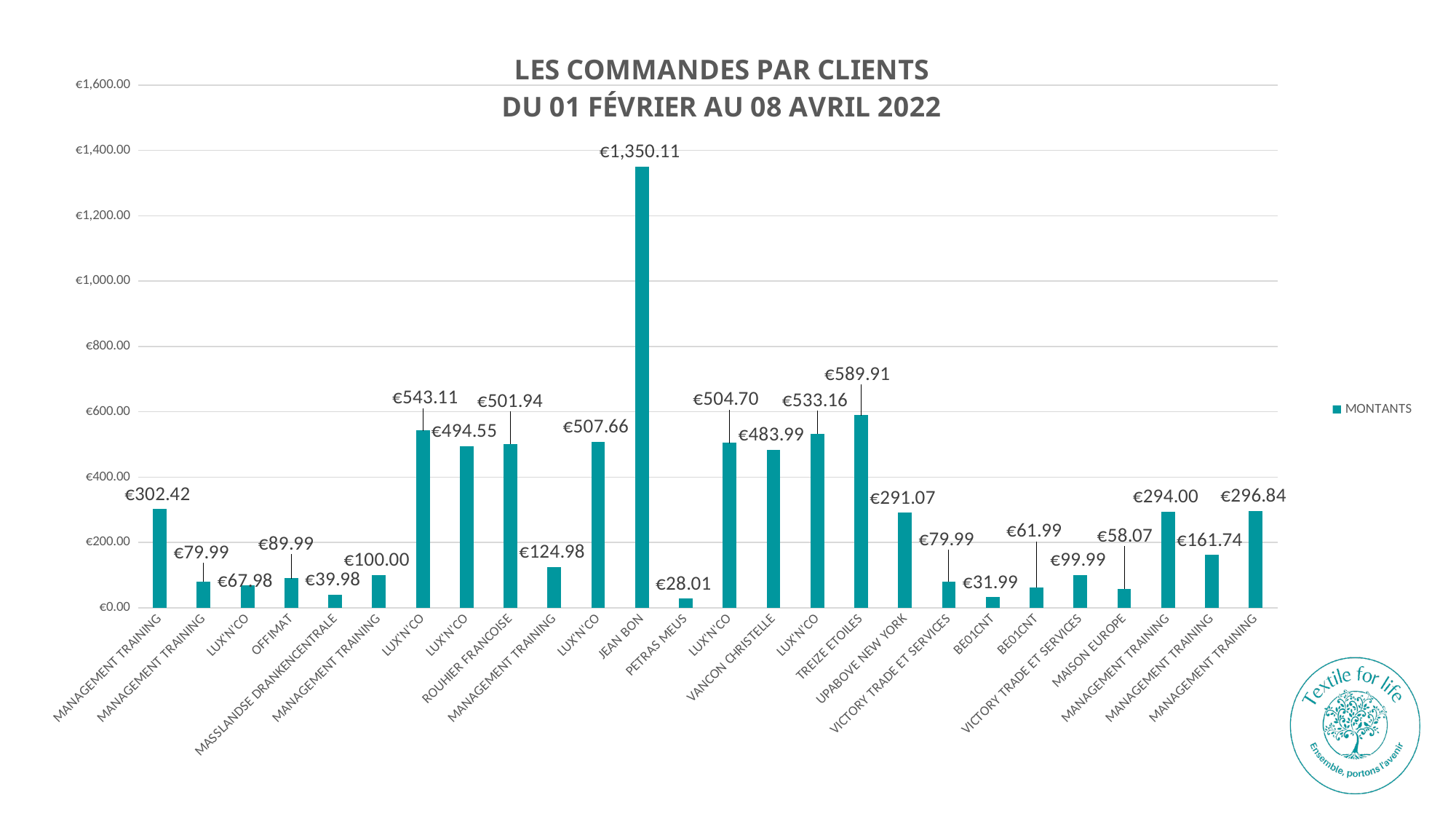
What is the value for TREIZE ETOILES? €589.91 What is the difference between the values for UPABOVE NEW YORK and MAISON EUROPE? €233.00 Which is larger, the value for OFFIMAT or the value for MASSLANDSE DRANKENCENTRALE? OFFIMAT What is the difference between the values for JEAN BON and TREIZE ETOILES? €760.20 What is the value for MASSLANDSE DRANKENCENTRALE? €39.98 Which client has the lowest amount? PETRAS MEUS How many bars are plotted in the chart? 26 What is the value for JEAN BON? €1,350.11 How many series does the legend list? 1 Which client has the highest amount? JEAN BON What is the value for UPABOVE NEW YORK? €291.07 What kind of chart is shown on the slide? Bar chart